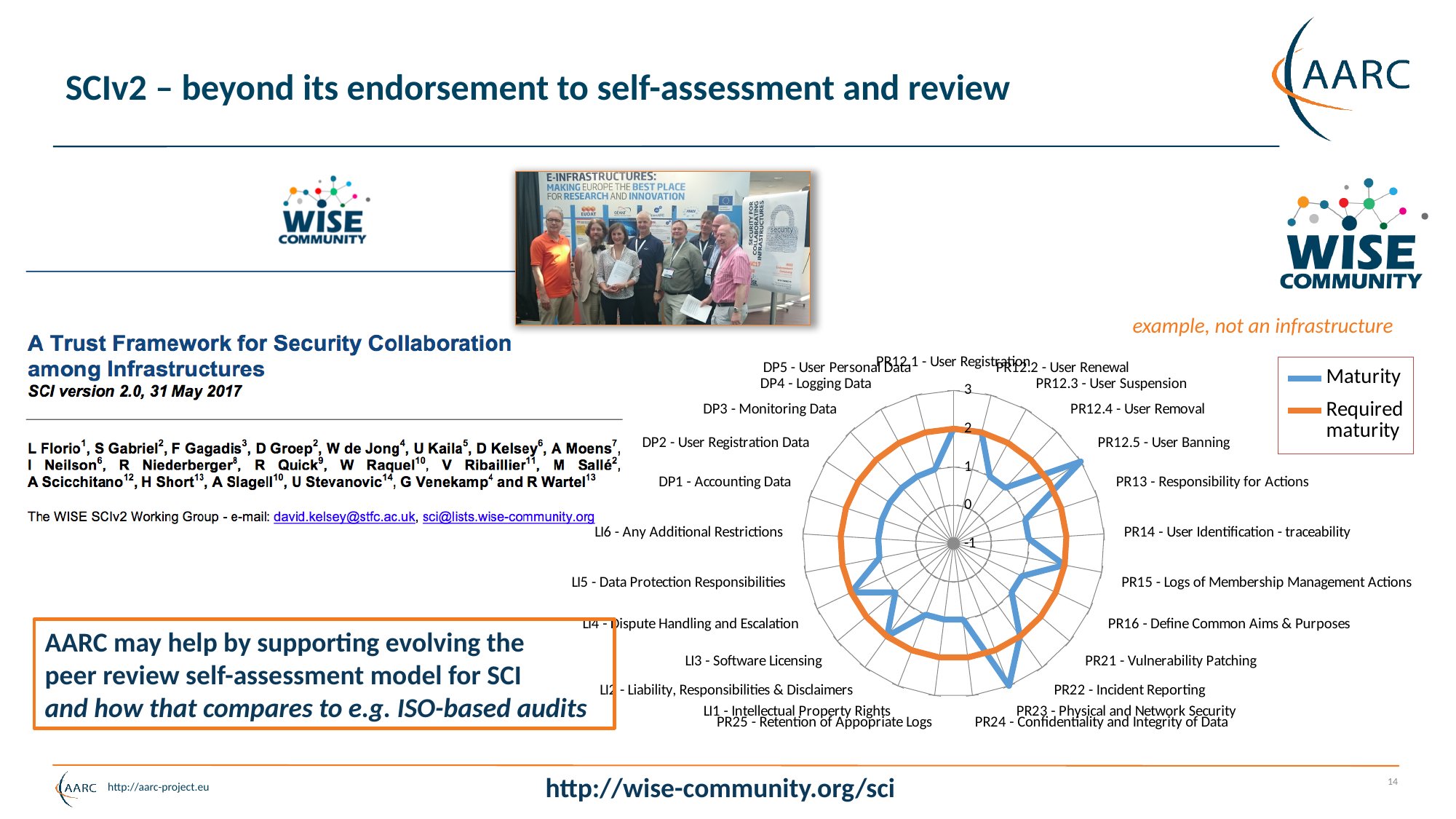
What is the Required maturity value for PR12.1 - User Registration? 2 How many series does the chart legend list? 2 Is the Maturity value for PR12.5 - User Banning greater or less than 2? greater Is the Maturity value for DP1 - Accounting Data greater or less than 2? less What are the two series named in the chart legend? Maturity and Required maturity How many categories are plotted around the radar chart? 25 Which colour is used for the Required maturity series in the chart? orange Is the Maturity value for DP5 - User Personal Data greater or less than 2? less What kind of chart is shown on the slide? radar chart Which has the higher Maturity value: PR12.5 - User Banning or DP5 - User Personal Data? PR12.5 - User Banning